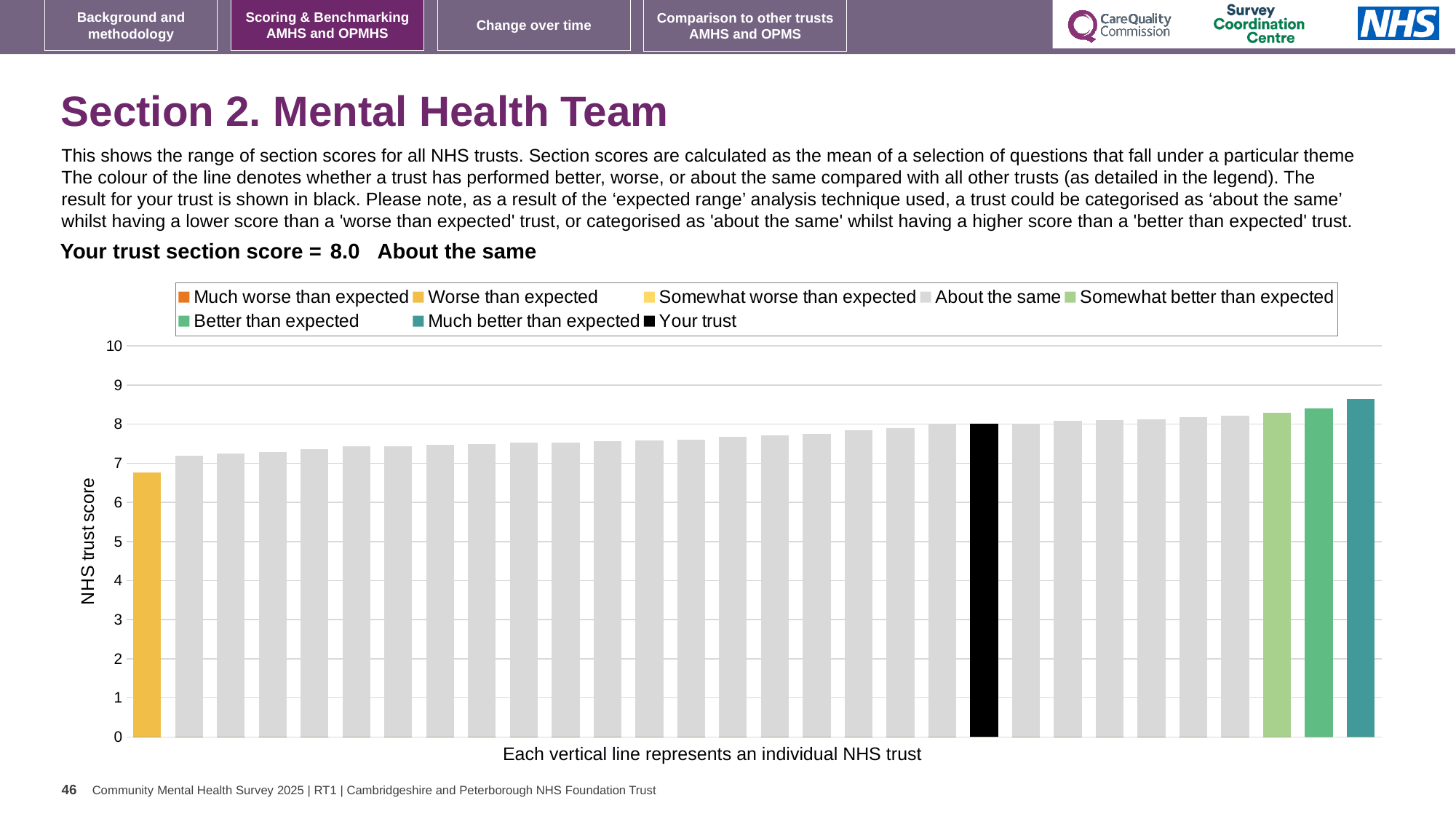
Which bar has the highest value: the leftmost yellow bar or the rightmost teal bar? the rightmost teal bar Which legend category does the highest bar in the chart belong to? Much better than expected Which legend category does the lowest bar in the chart belong to? Worse than expected Do the bar values rise or fall from left to right along the x axis? rise How many bars (NHS trusts) are plotted in the chart? 30 Is the value of the leftmost (yellow) bar greater or less than 7? less What is the section score for your trust shown on the slide? 8.0 Is the value of the rightmost (teal) bar greater or less than 8? greater What colour is the bar representing your trust? black How many entries does the chart legend list? 8 What kind of chart is shown on the slide? bar chart What is the label on the vertical axis of the chart? NHS trust score